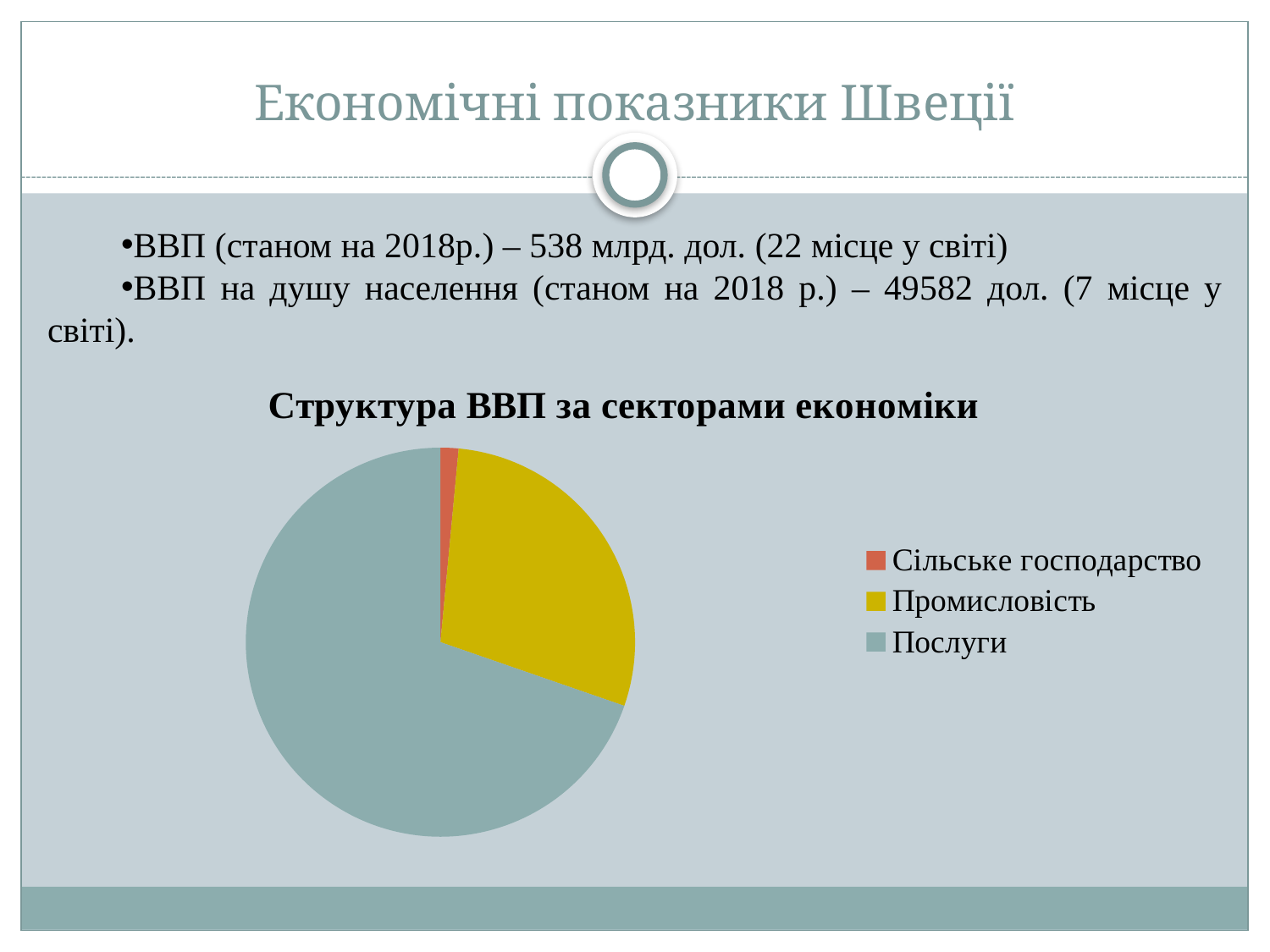
Which slice is larger in the pie chart: Промисловість or Сільське господарство? Промисловість How many slices does the pie chart have? 3 How many entries does the legend of the pie chart list? 3 What kind of chart is shown under the title "Структура ВВП за секторами економіки"? pie chart Which slice is larger in the pie chart: Послуги or Промисловість? Послуги Does the Послуги slice take up more or less than half of the pie chart? more Which sector has the largest slice in the pie chart? Послуги Which sector has the smallest slice in the pie chart? Сільське господарство What is the title of the chart on the slide? Структура ВВП за секторами економіки Which colour represents Промисловість in the pie chart? yellow